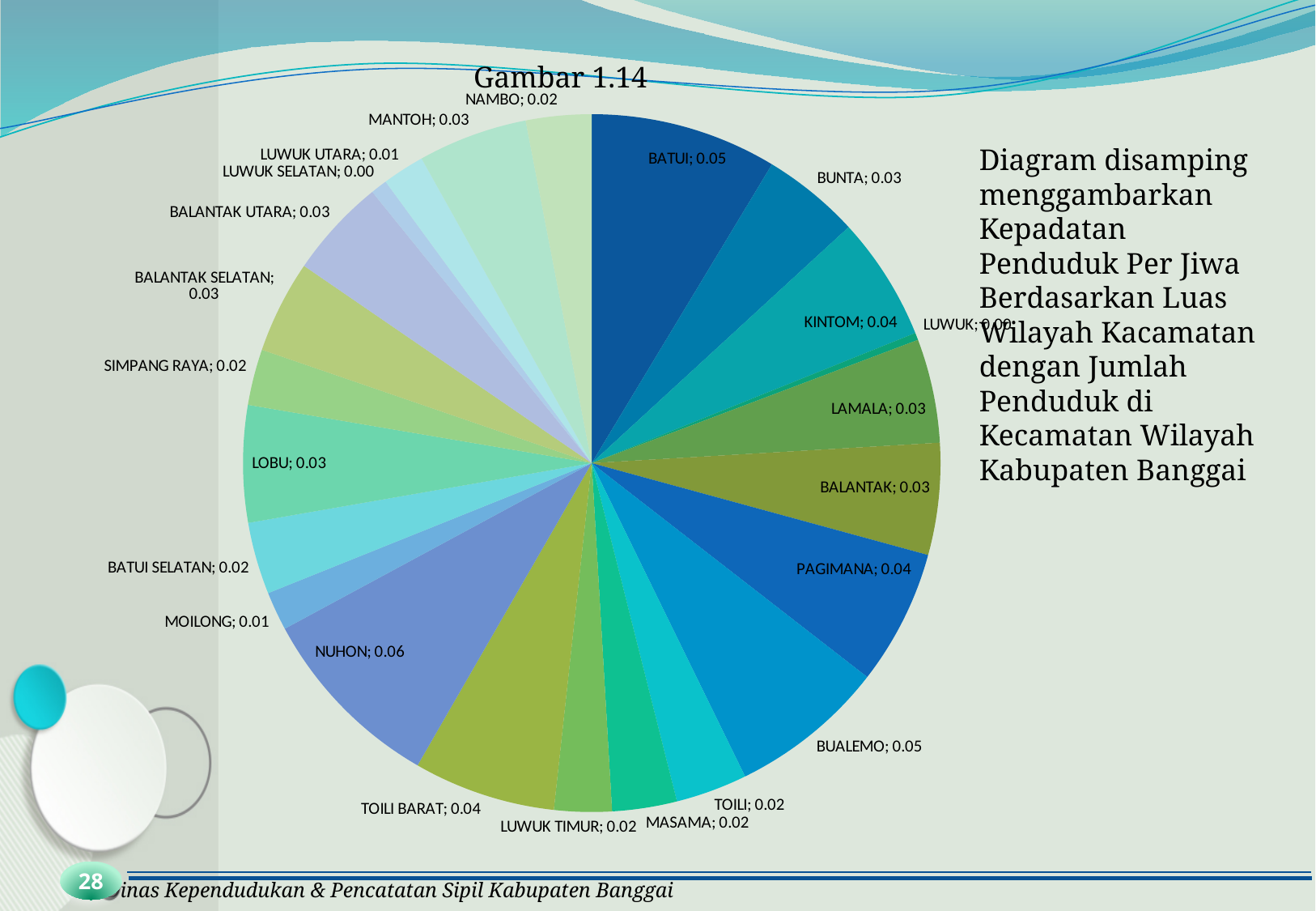
What is the difference between the values for BUALEMO and TOILI? 0.03 Which category has the highest value in the pie chart? NUHON What is the title of the chart on the slide? Gambar 1.14 Which has a larger value, BATUI or BUNTA? BATUI What is the value shown for LUWUK SELATAN in the pie chart? 0.00 What is the value shown for NUHON in the pie chart? 0.06 What is the value shown for BATUI in the pie chart? 0.05 What is the value shown for PAGIMANA in the pie chart? 0.04 Which has a larger value, KINTOM or LUWUK UTARA? KINTOM What is the value shown for MOILONG in the pie chart? 0.01 What is the difference between the values for NUHON and MOILONG? 0.05 What type of chart is shown on the slide? Pie chart